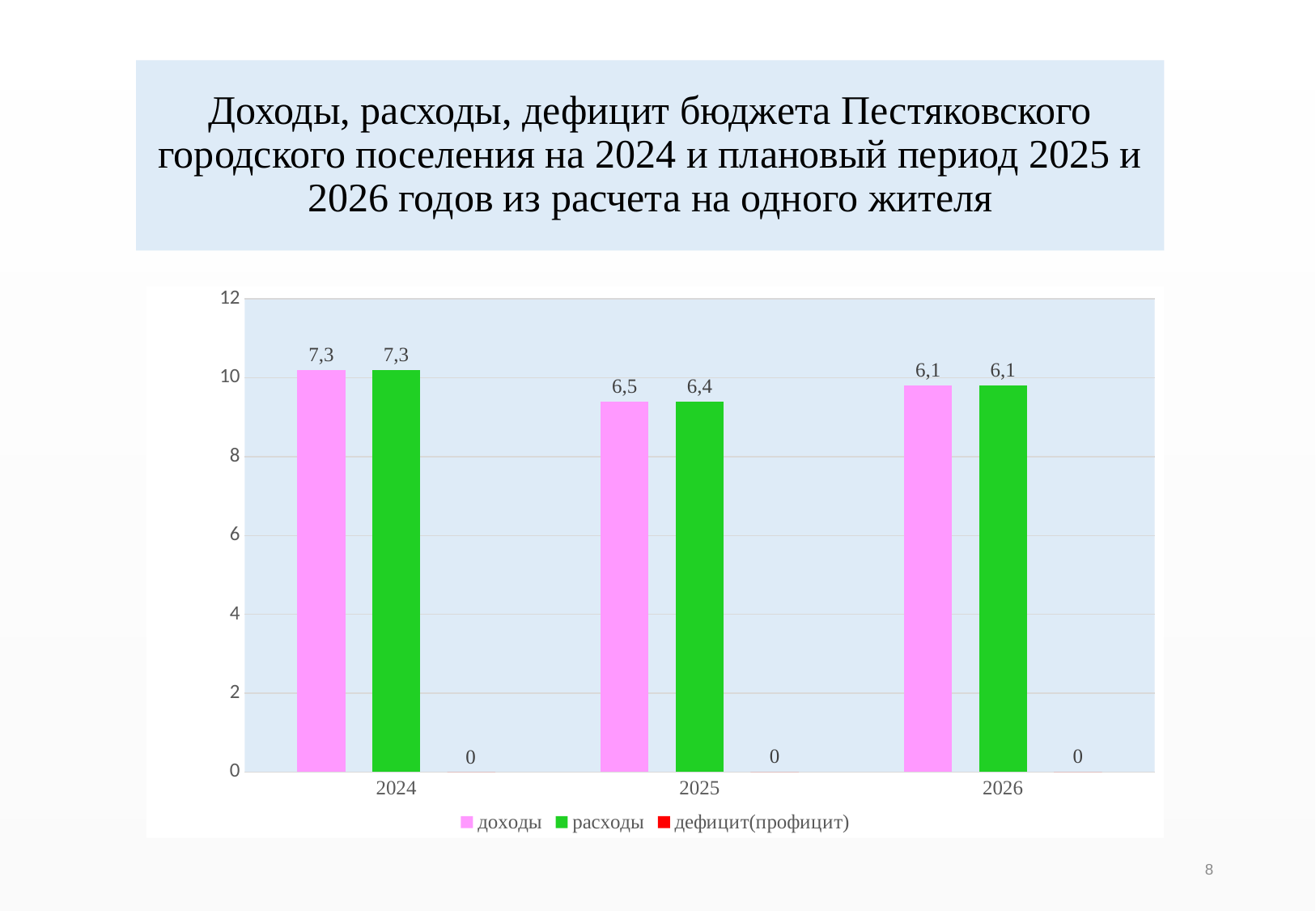
What is the value of доходы for 2026? 6,1 What is the value of доходы for 2024? 7,3 What is the value of расходы for 2025? 6,4 What is the value of дефицит(профицит) for 2025? 0 In which year is the value of доходы the highest? 2024 What type of chart is shown on the slide? bar chart How many series does the legend list? 3 How many years (categories) are shown on the x axis? 3 Do the values of доходы rise or fall from 2024 to 2026? fall